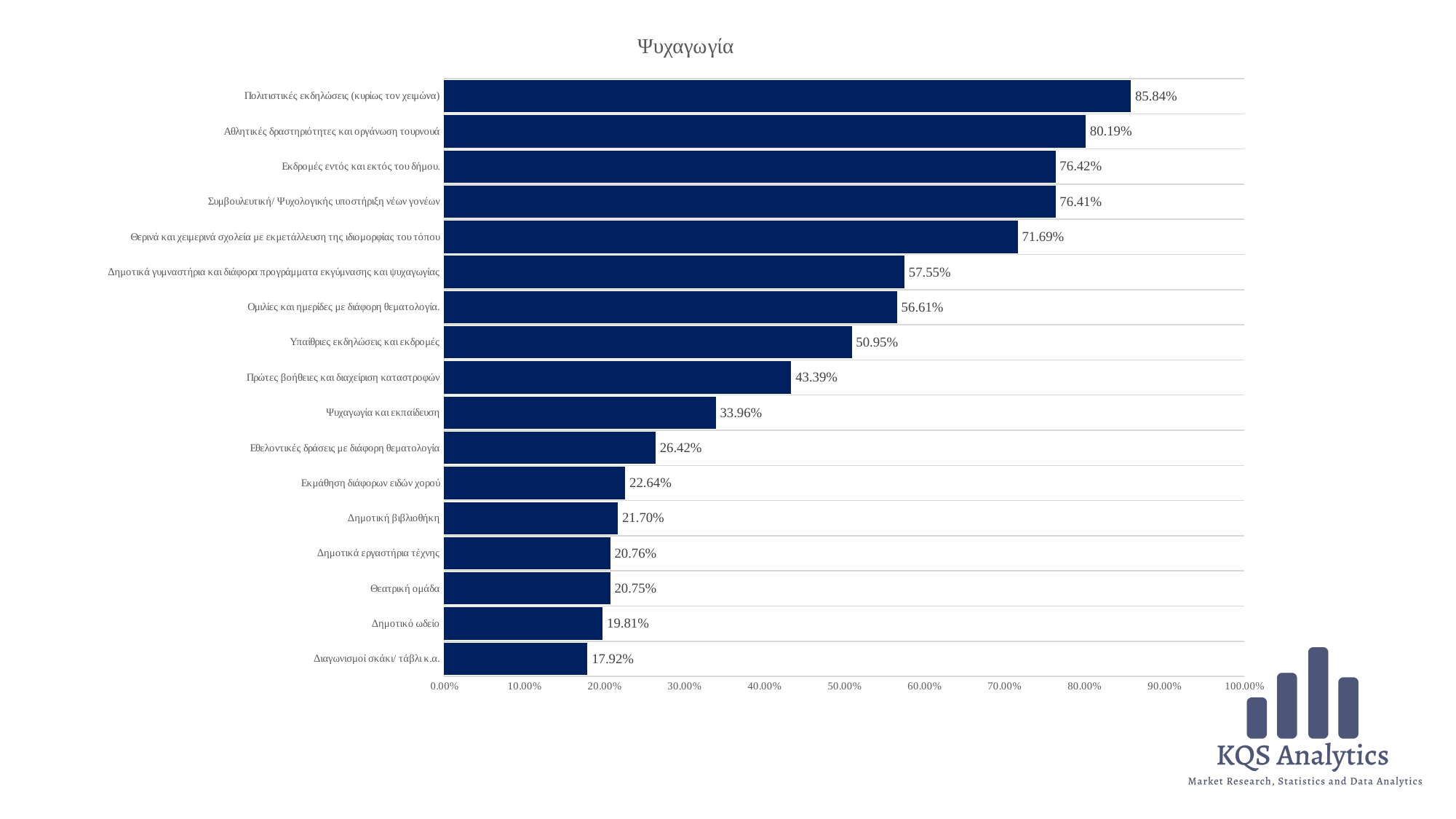
What is the difference between the values for Πολιτιστικές εκδηλώσεις (κυρίως τον χειμώνα) and Αθλητικές δραστηριότητες και οργάνωση τουρνουά? 5.65% What is the value for Δημοτική βιβλιοθήκη? 21.70% What is the value for Πολιτιστικές εκδηλώσεις (κυρίως τον χειμώνα)? 85.84% What is the value for Πρώτες βοήθειες και διαχείριση καταστροφών? 43.39% Which category has the highest value? Πολιτιστικές εκδηλώσεις (κυρίως τον χειμώνα) How many categories are plotted in the chart? 17 Is the value for Ψυχαγωγία και εκπαίδευση greater or less than 40.00%? less What is the title of the chart? Ψυχαγωγία What kind of chart is shown on the slide? bar chart Is the value for Θερινά και χειμερινά σχολεία με εκμετάλλευση της ιδιομορφίας του τόπου greater or less than 60.00%? greater Which category has the lowest value? Διαγωνισμοί σκάκι/ τάβλι κ.α. Which is larger, the value for Δημοτική βιβλιοθήκη or the value for Δημοτικό ωδείο? Δημοτική βιβλιοθήκη